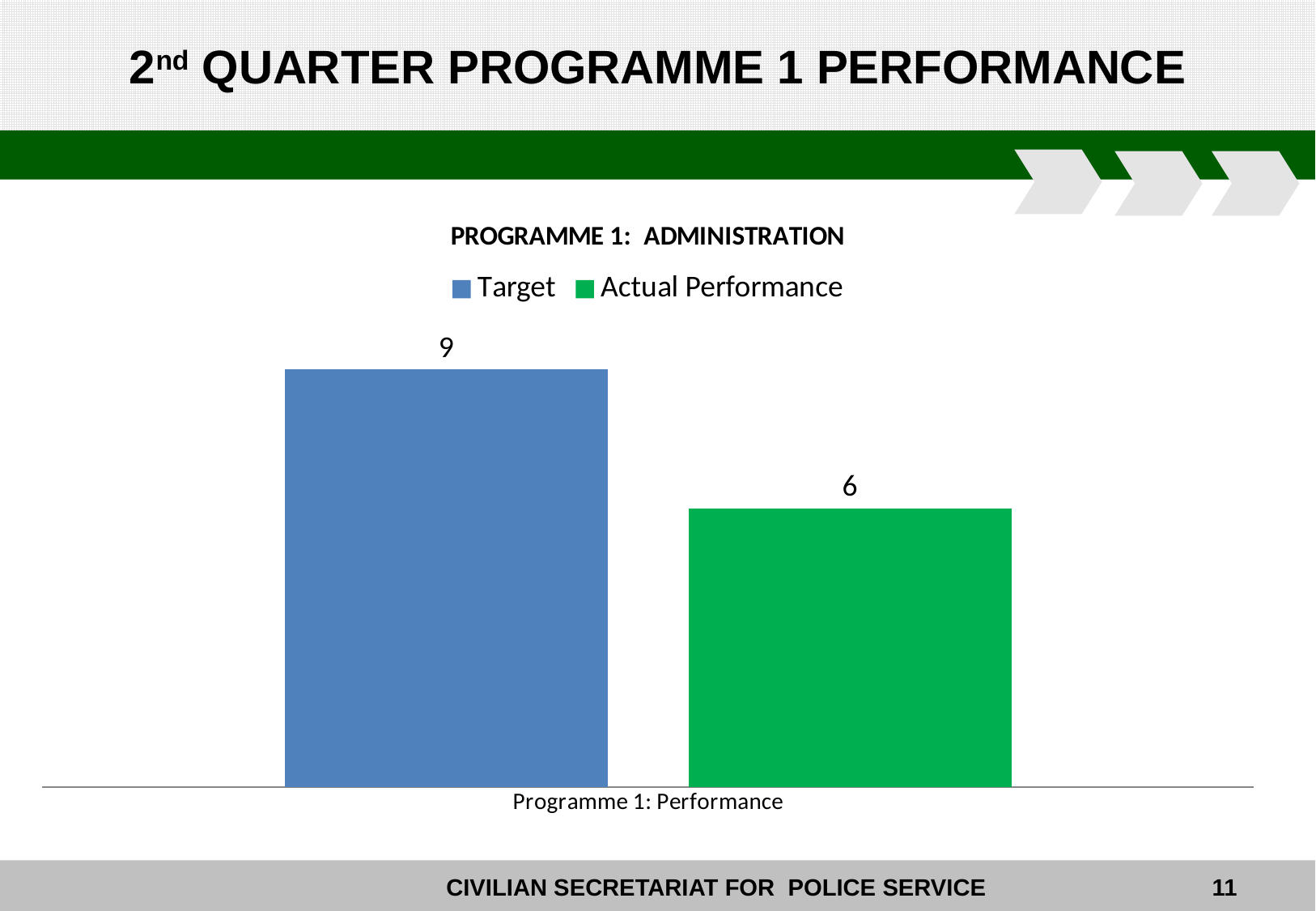
How many bars are plotted in the chart? 2 What is the total of the Target and Actual Performance values? 15 What is the title of the chart? PROGRAMME 1: ADMINISTRATION What is the difference between the Target and the Actual Performance values? 3 What kind of chart is shown on the slide? Bar chart How many series does the legend list? 2 Which series has the lowest value in the chart? Actual Performance What is the category label shown on the x axis of the chart? Programme 1: Performance Which series has the higher value, Target or Actual Performance? Target What is the Target value shown in the chart? 9 What is the Actual Performance value shown in the chart? 6